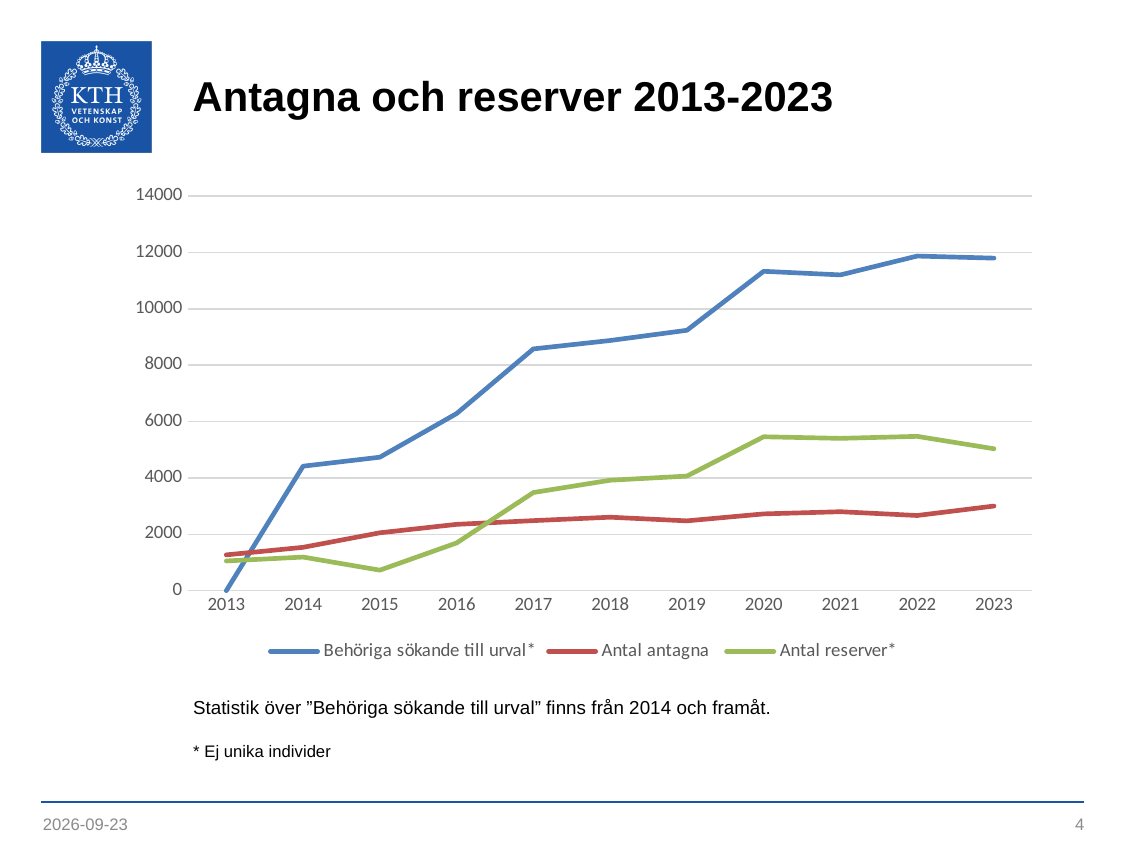
What kind of chart is shown on the slide? line chart Does Behöriga sökande till urval rise or fall from 2014 to 2020? rise What is the title of the chart? Antagna och reserver 2013-2023 How many series does the legend list? 3 In which year is Antal reserver at its lowest? 2015 Is the value for Behöriga sökande till urval in 2022 greater or less than 10000? greater Is the value for Antal reserver in 2015 greater or less than 2000? less In 2015, which is larger, Antal antagna or Antal reserver? Antal antagna In 2020, which is larger, Antal reserver or Antal antagna? Antal reserver Is the value for Behöriga sökande till urval in 2017 greater or less than 8000? greater How many years are shown on the x axis? 11